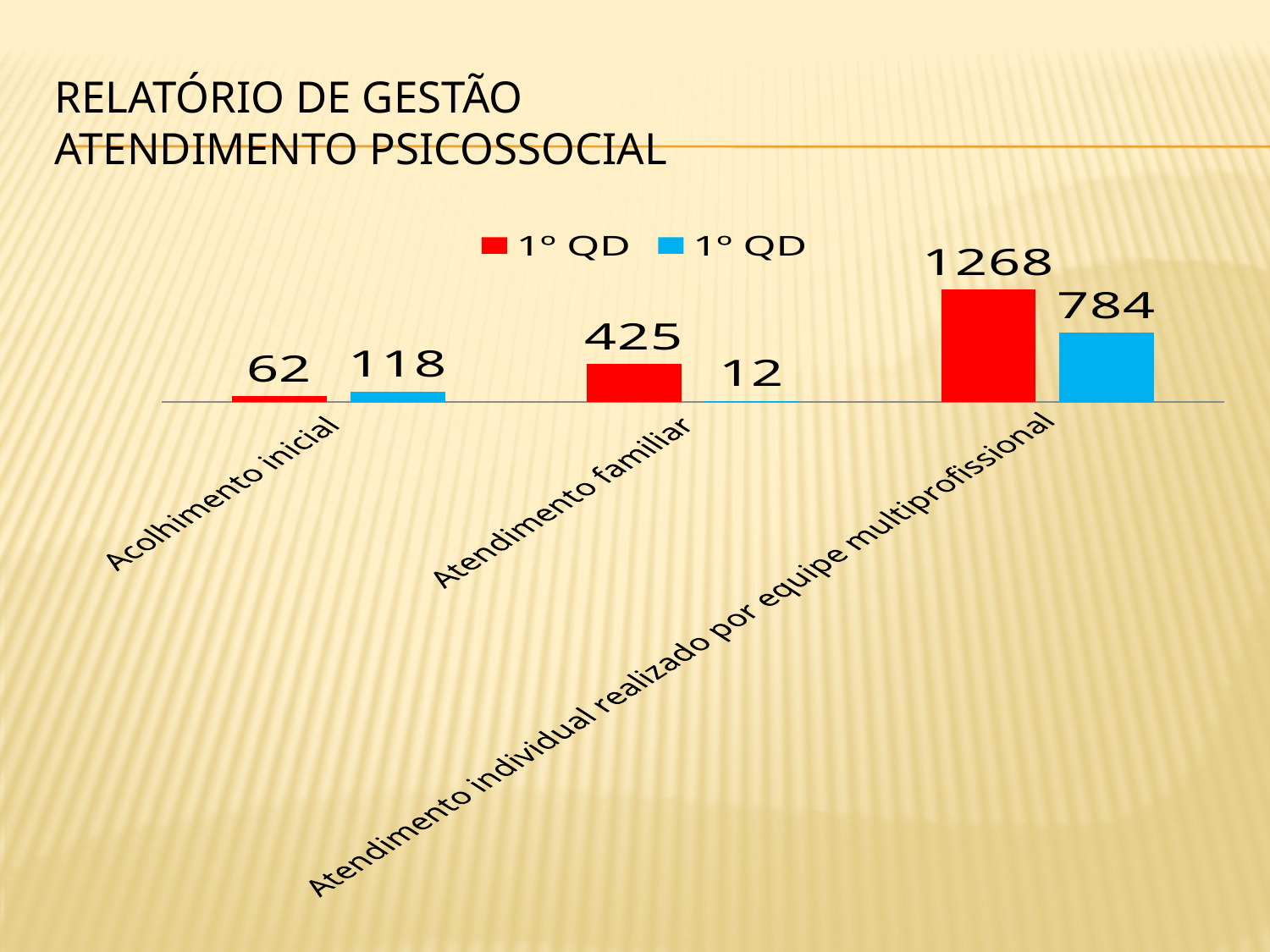
What is the value of the red bar for Atendimento familiar? 425 For Acolhimento inicial, which is larger, the red bar or the blue bar? the blue bar How many categories are shown on the x axis of the chart? 3 How many series does the legend list? 2 What is the value of the blue bar for Atendimento familiar? 12 What is the value of the blue bar for Atendimento individual realizado por equipe multiprofissional? 784 Which category has the lowest blue bar value? Atendimento familiar What is the value of the red bar for Acolhimento inicial? 62 Which category has the highest red bar value? Atendimento individual realizado por equipe multiprofissional What kind of chart is shown on the slide? bar chart What is the difference between the red and blue bars for Atendimento individual realizado por equipe multiprofissional? 484 What is the value of the blue bar for Acolhimento inicial? 118